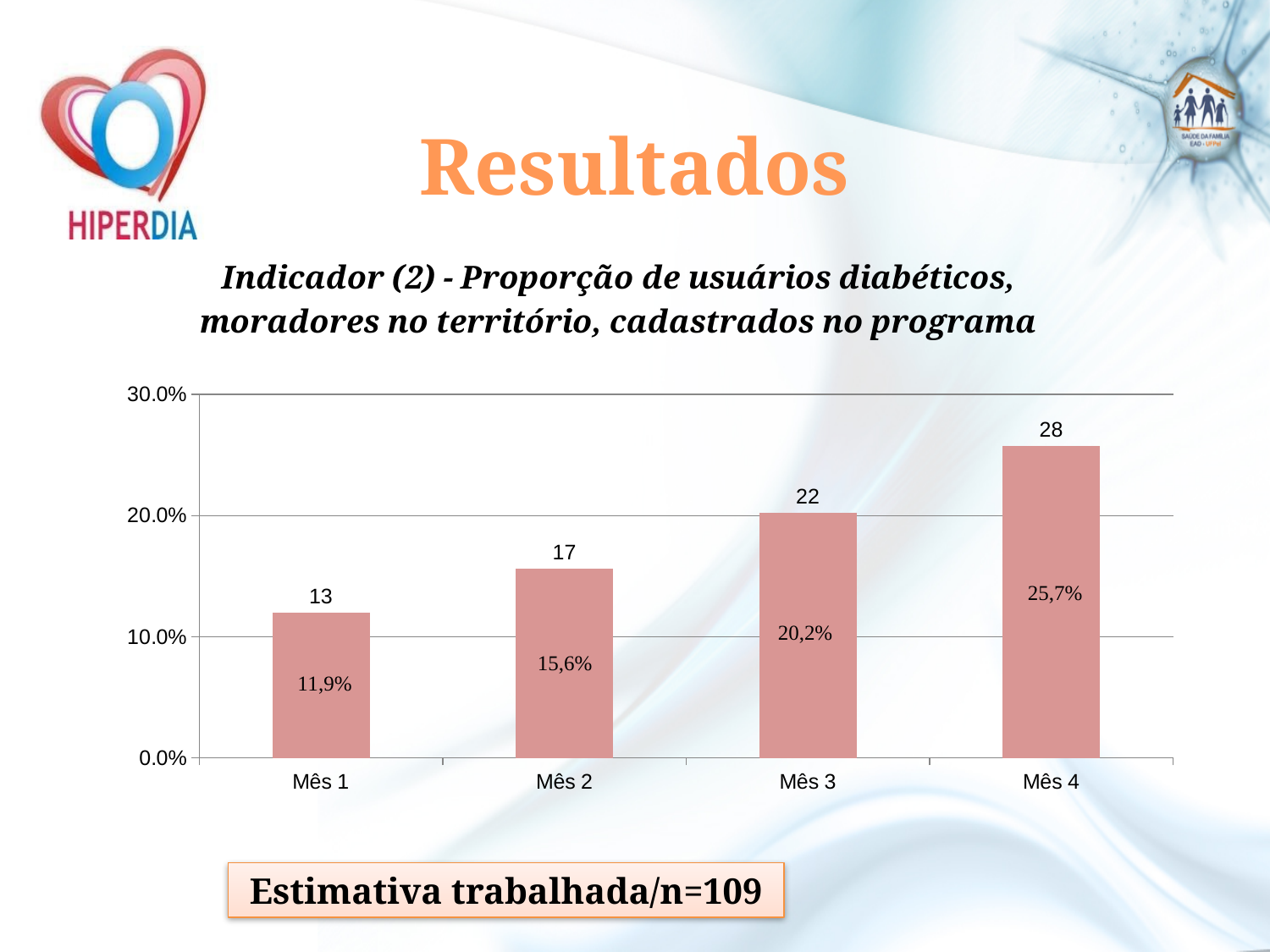
Which month has the lowest proportion? Mês 1 What is the count label printed above the bar for Mês 2? 17 Which is larger, the value for Mês 2 or the value for Mês 3? Mês 3 What kind of chart is shown on the slide? bar chart What percentage is shown for Mês 3? 20,2% What is the difference between the count labels for Mês 3 and Mês 2? 5 What percentage is shown for Mês 1? 11,9% How many months are shown on the x axis? 4 Do the values rise or fall from Mês 1 to Mês 4? rise What is the difference in percentage points between Mês 4 and Mês 1? 13,8 Which month has the highest proportion? Mês 4 Is the value for Mês 4 greater or less than 20.0%? greater